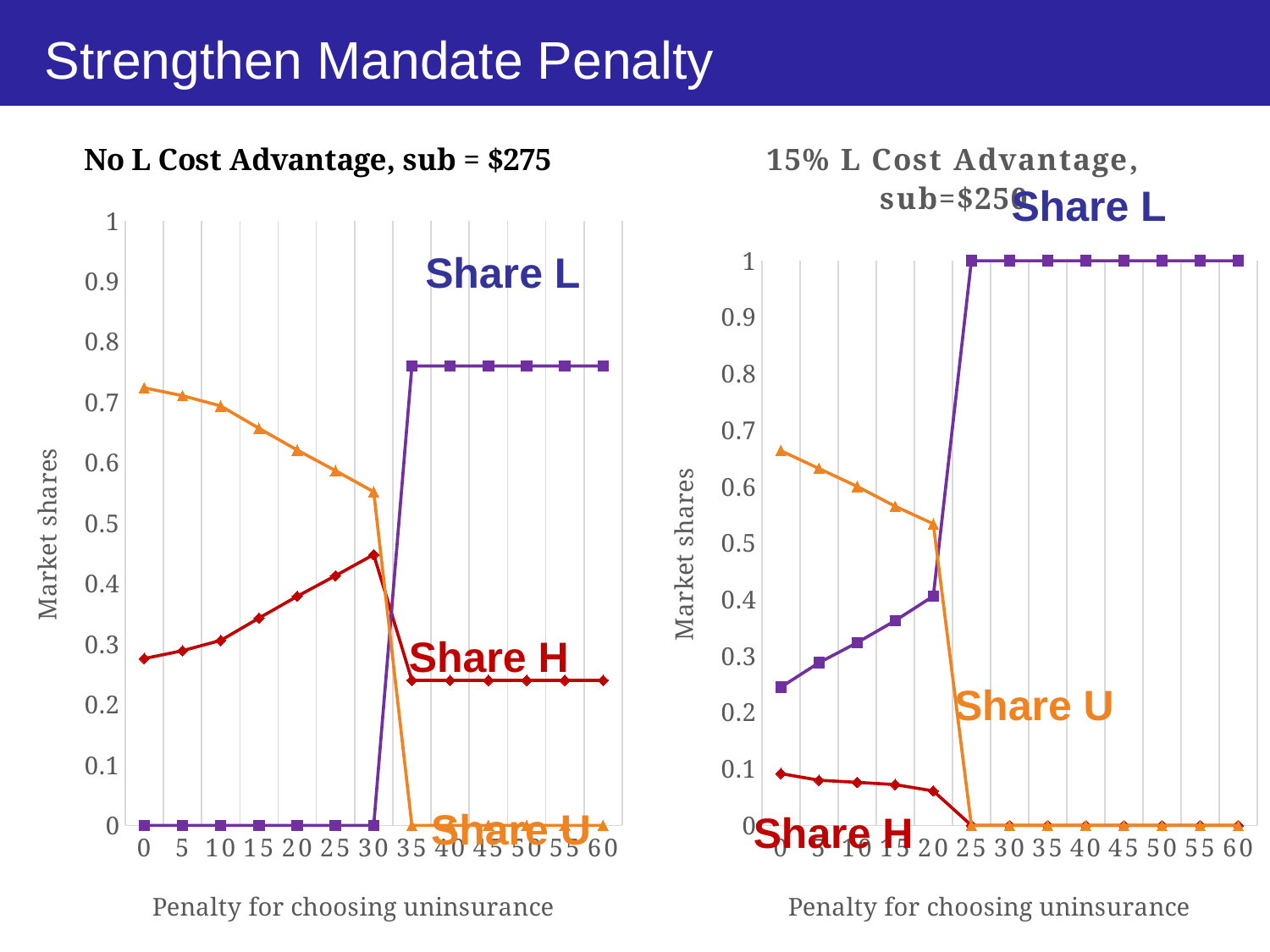
What kind of chart is the left chart titled 'No L Cost Advantage, sub = $275'? line chart In the left chart (No L Cost Advantage, sub = $275), how many penalty values are plotted along the x axis? 13 In the left chart (No L Cost Advantage, sub = $275), what is the value of Share L at a penalty of 0? 0 In the left chart (No L Cost Advantage, sub = $275), does Share U rise or fall as the penalty increases from 0 to 30? fall In the right chart (15% L Cost Advantage, sub=$250), which is larger at a penalty of 0: Share U or Share H? Share U In the right chart (15% L Cost Advantage, sub=$250), how many series are plotted? 3 In the left chart (No L Cost Advantage, sub = $275), is the value of Share U at a penalty of 0 greater or less than 0.6? greater In the left chart (No L Cost Advantage, sub = $275), is the value of Share L at a penalty of 60 greater or less than 0.7? greater In the right chart (15% L Cost Advantage, sub=$250), what is the value of Share L at a penalty of 60? 1 In the right chart (15% L Cost Advantage, sub=$250), what is the value of Share U at a penalty of 40? 0 What is the x-axis title of the right chart (15% L Cost Advantage, sub=$250)? Penalty for choosing uninsurance In the right chart (15% L Cost Advantage, sub=$250), is the value of Share H at a penalty of 0 greater or less than 0.2? less